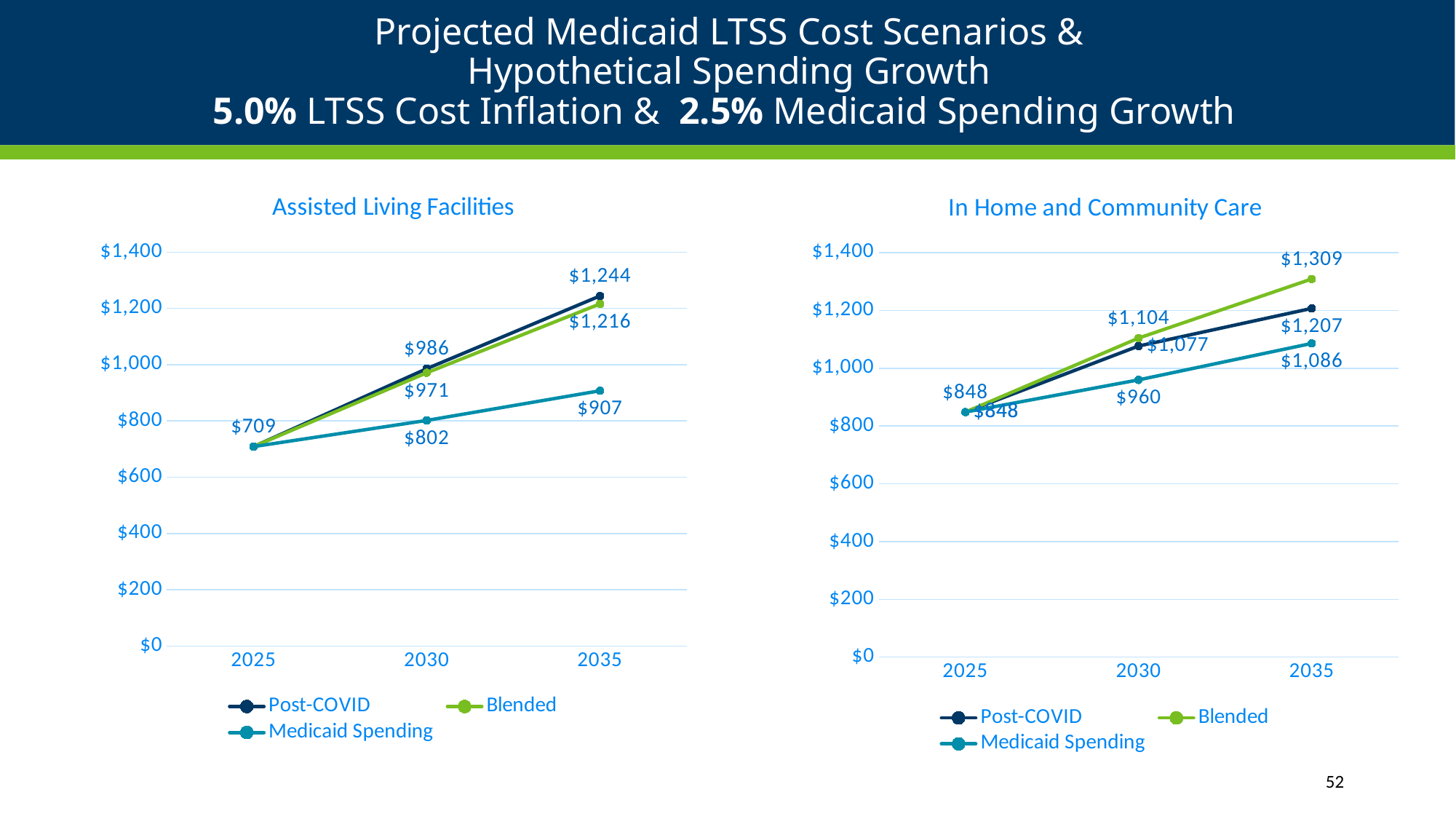
In the In Home and Community Care chart, is the Post-COVID value in 2030 larger or smaller than the Blended value in 2030? smaller What kind of chart is the In Home and Community Care chart? line chart In the Assisted Living Facilities chart, what is the difference between the Post-COVID and Medicaid Spending values in 2035? $337 In the Assisted Living Facilities chart, what is the Post-COVID value in 2035? $1,244 In the In Home and Community Care chart, which series has the highest value in 2035? Blended In the In Home and Community Care chart, what is the Medicaid Spending value in 2030? $960 In the In Home and Community Care chart, what is the difference between the Blended and Post-COVID values in 2035? $102 In the Assisted Living Facilities chart, which series has the lowest value in 2035? Medicaid Spending In the In Home and Community Care chart, what is the Blended value in 2035? $1,309 How many series does the legend of the Assisted Living Facilities chart list? 3 In the Assisted Living Facilities chart, what is the Medicaid Spending value in 2030? $802 In the Assisted Living Facilities chart, what is the value shared by all three series in 2025? $709